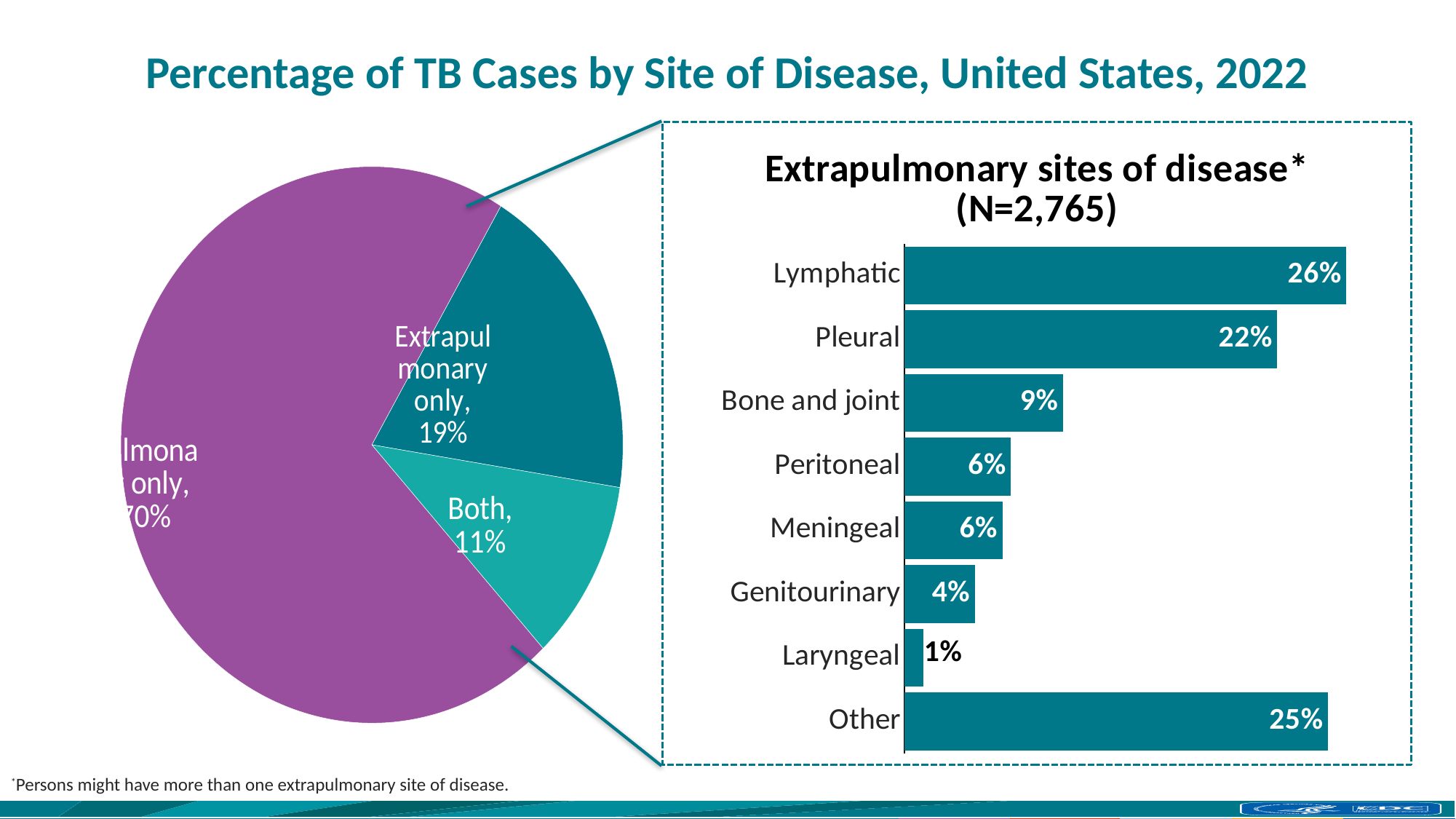
In the bar chart titled 'Extrapulmonary sites of disease', which site has the lowest percentage? Laryngeal In the bar chart titled 'Extrapulmonary sites of disease', which is larger, Bone and joint or Peritoneal? Bone and joint In the bar chart titled 'Extrapulmonary sites of disease', what is the difference between the Lymphatic and Pleural percentages? 4% What kind of chart is the chart titled 'Extrapulmonary sites of disease'? Bar chart In the bar chart titled 'Extrapulmonary sites of disease', what is the value for Pleural? 22% In the bar chart titled 'Extrapulmonary sites of disease', which site has the highest percentage? Lymphatic In the pie chart on the left, what percentage is shown for 'Extrapulmonary only'? 19% How many sites are listed in the bar chart titled 'Extrapulmonary sites of disease'? 8 In the pie chart on the left, what percentage is shown for 'Both'? 11% In the bar chart titled 'Extrapulmonary sites of disease', what is the value for Lymphatic? 26% In the bar chart titled 'Extrapulmonary sites of disease', what is the value for Genitourinary? 4% What is the N value shown in the title of the bar chart on the right? N=2,765